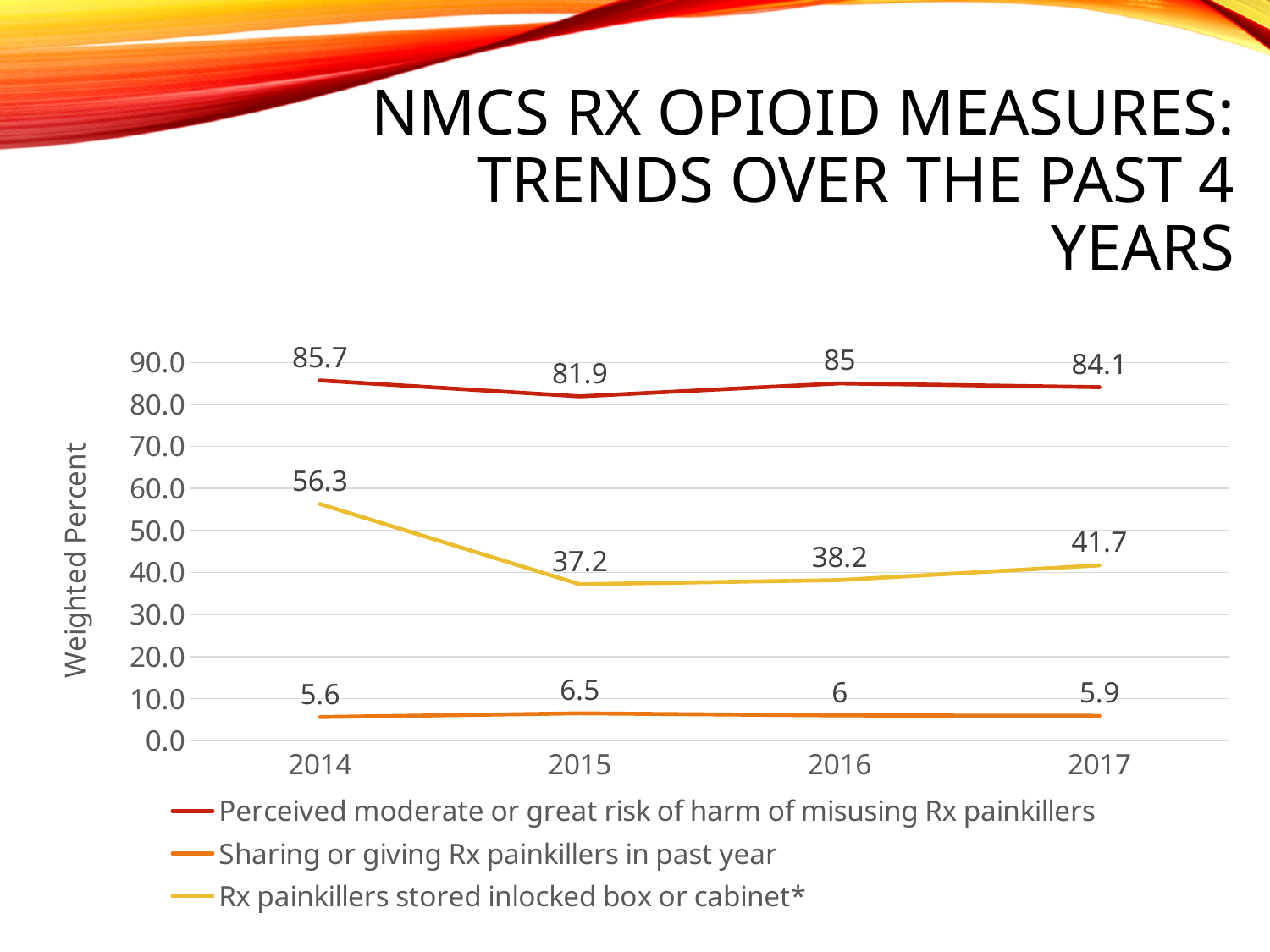
What is the value for 'Sharing or giving Rx painkillers in past year' in 2017? 5.9 In which year is 'Rx painkillers stored inlocked box or cabinet*' highest? 2014 What kind of chart is shown on the slide? line chart What is the value for 'Rx painkillers stored inlocked box or cabinet*' in 2015? 37.2 What is the difference between the 2014 and 2015 values for 'Rx painkillers stored inlocked box or cabinet*'? 19.1 What is the label of the y axis? Weighted Percent Is the 2017 value for 'Rx painkillers stored inlocked box or cabinet*' greater or less than 40.0? greater How many series does the legend list? 3 How many years are shown on the x axis? 4 In which year is 'Perceived moderate or great risk of harm of misusing Rx painkillers' lowest? 2015 Which is larger: 'Sharing or giving Rx painkillers in past year' in 2015 or in 2016? 2015 What is the value for 'Perceived moderate or great risk of harm of misusing Rx painkillers' in 2014? 85.7